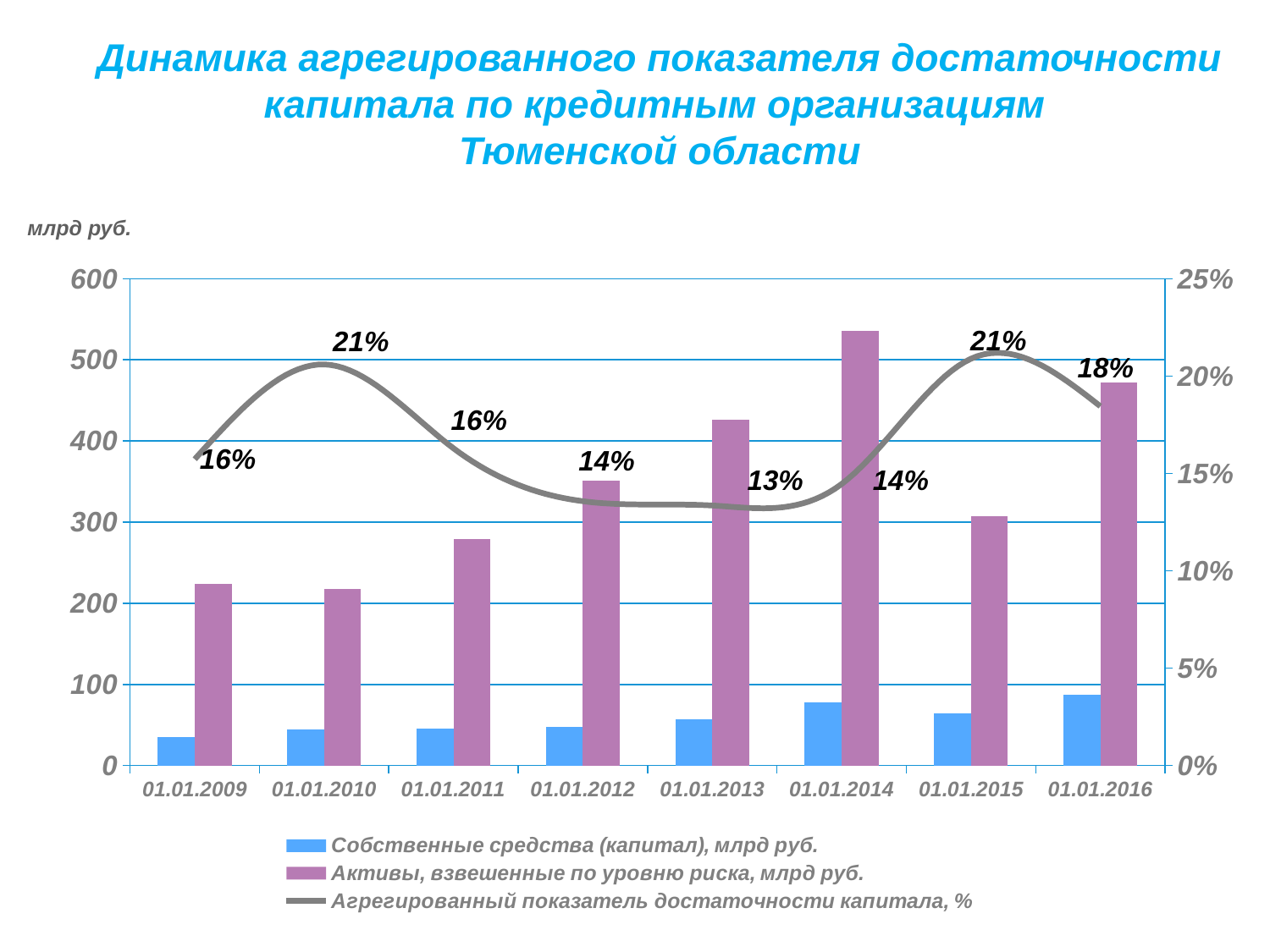
Does the aggregated capital adequacy ratio rise or fall from 01.01.2013 to 01.01.2015? rise What is the aggregated capital adequacy ratio on 01.01.2016? 18% What is the aggregated capital adequacy ratio (Агрегированный показатель достаточности капитала) on 01.01.2013? 13% On which date is the aggregated capital adequacy ratio the lowest? 01.01.2013 Which is larger: the aggregated capital adequacy ratio on 01.01.2010 or on 01.01.2016? 01.01.2010 On which date are the risk-weighted assets (Активы, взвешенные по уровню риска) the highest? 01.01.2014 How many dates are shown on the x axis? 8 How many series does the legend list? 3 Is the value of risk-weighted assets on 01.01.2014 greater or less than 500 млрд руб.? greater Is the value of own funds (Собственные средства) on 01.01.2016 greater or less than 100 млрд руб.? less What is the aggregated capital adequacy ratio on 01.01.2010? 21% By how many percentage points does the aggregated capital adequacy ratio on 01.01.2015 exceed the value on 01.01.2012? 7 percentage points